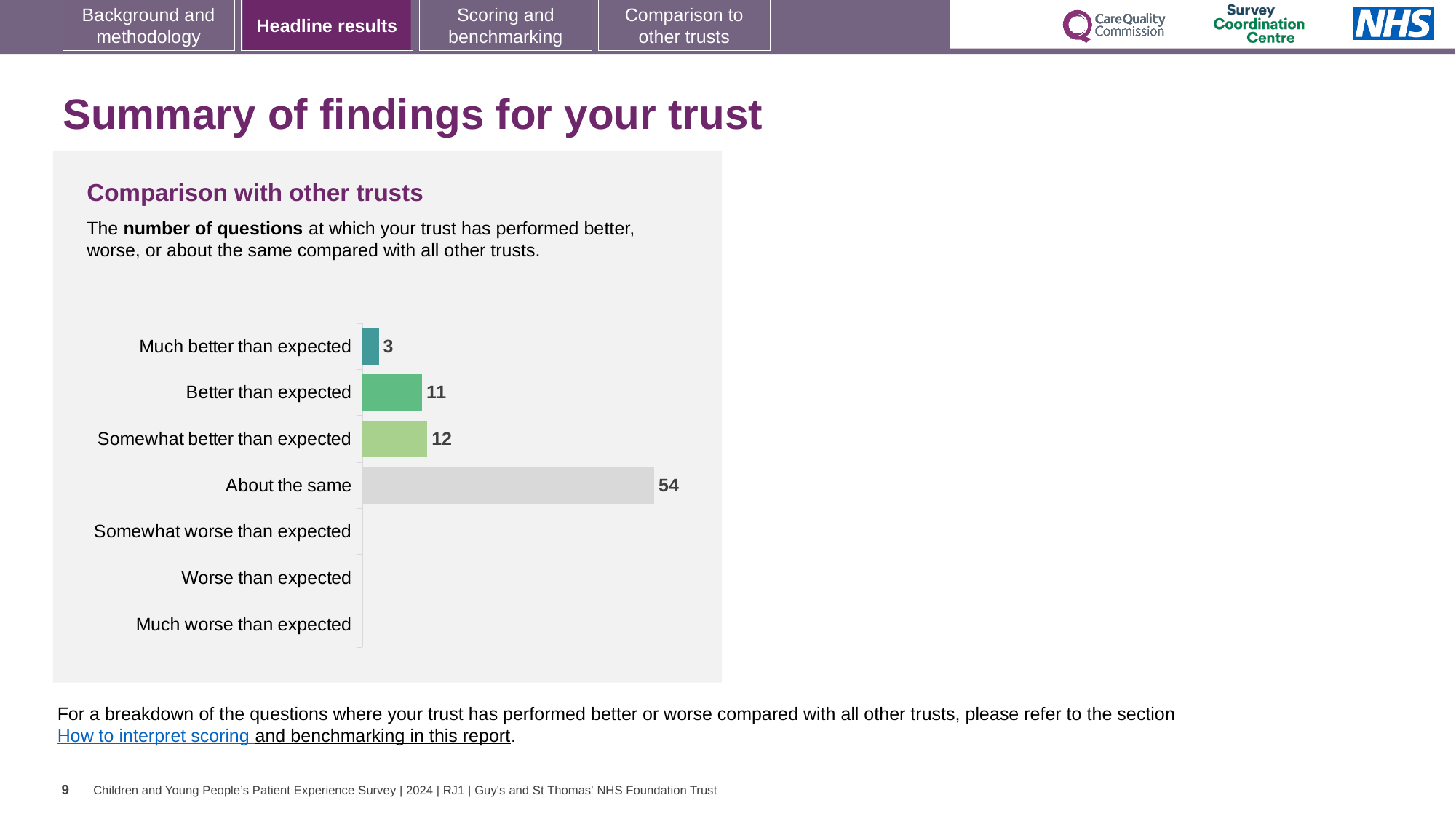
What is the title of the chart panel on the slide? Comparison with other trusts What is the value shown for "Somewhat better than expected"? 12 What is the difference between the values for "About the same" and "Somewhat better than expected"? 42 What is the value for "About the same" in the Comparison with other trusts chart? 54 How many categories have a bar with a data label shown? 4 Which category has the highest value in the chart? About the same What is the value shown for "Better than expected"? 11 Which is larger: the value for "Better than expected" or the value for "Much better than expected"? Better than expected What is the difference between the values for "Better than expected" and "Much better than expected"? 8 How many categories are listed on the chart's vertical axis? 7 What kind of chart is shown on the slide? Bar chart How many questions were rated "Much better than expected"? 3